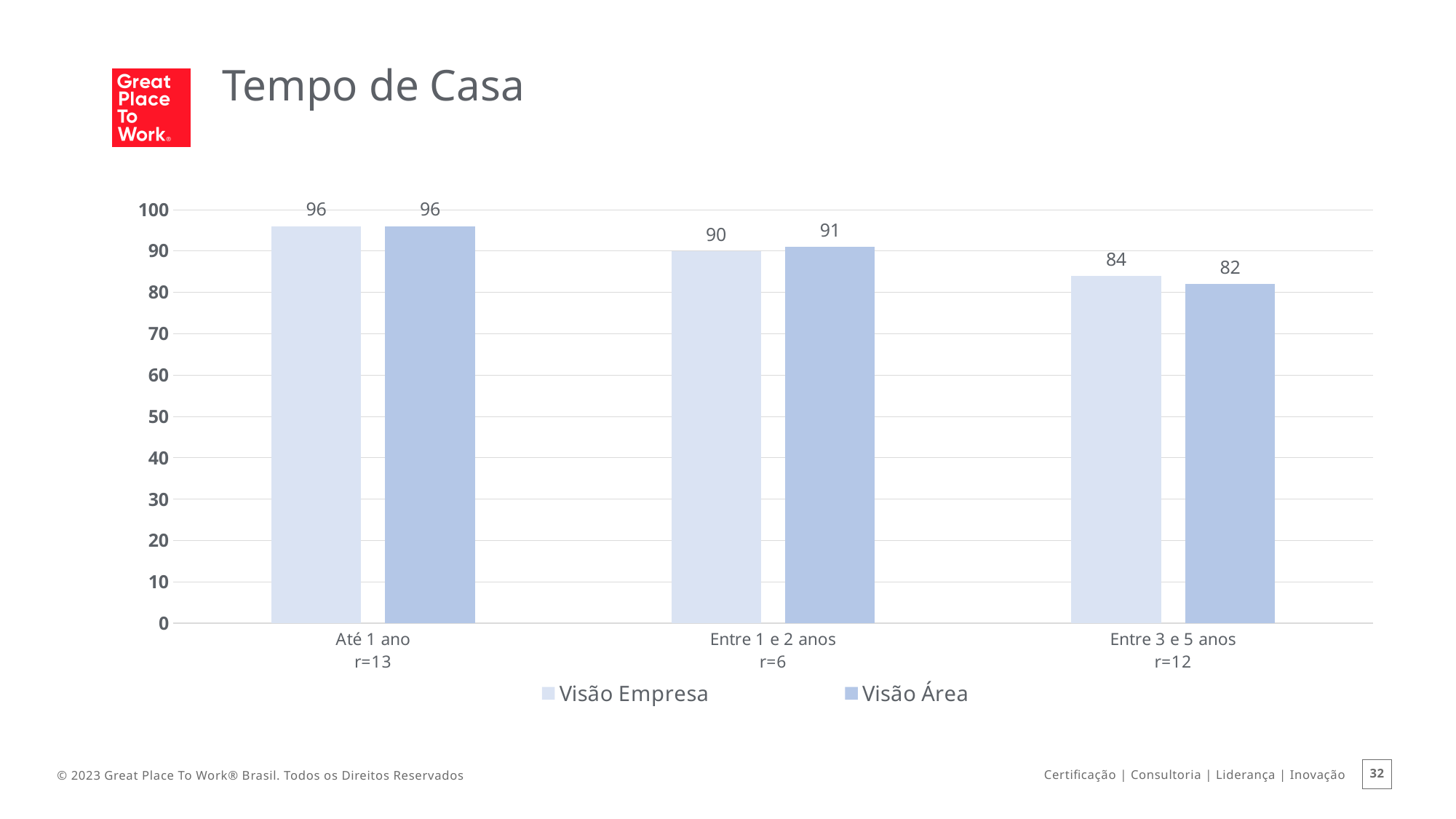
Which category has the lowest Visão Empresa value? Entre 3 e 5 anos Which category has the highest Visão Área value? Até 1 ano What is the Visão Área value for Entre 1 e 2 anos? 91 What is the title of the slide? Tempo de Casa What is the difference between the Visão Empresa and Visão Área values for Entre 3 e 5 anos? 2 For Entre 1 e 2 anos, which is larger: Visão Empresa or Visão Área? Visão Área How many categories are shown on the x axis? 3 Do the Visão Empresa values rise or fall from Até 1 ano to Entre 3 e 5 anos? Fall What is the Visão Empresa value for Até 1 ano? 96 What kind of chart is shown on the slide? Bar chart What is the Visão Área value for Entre 3 e 5 anos? 82 How many series does the legend list? 2